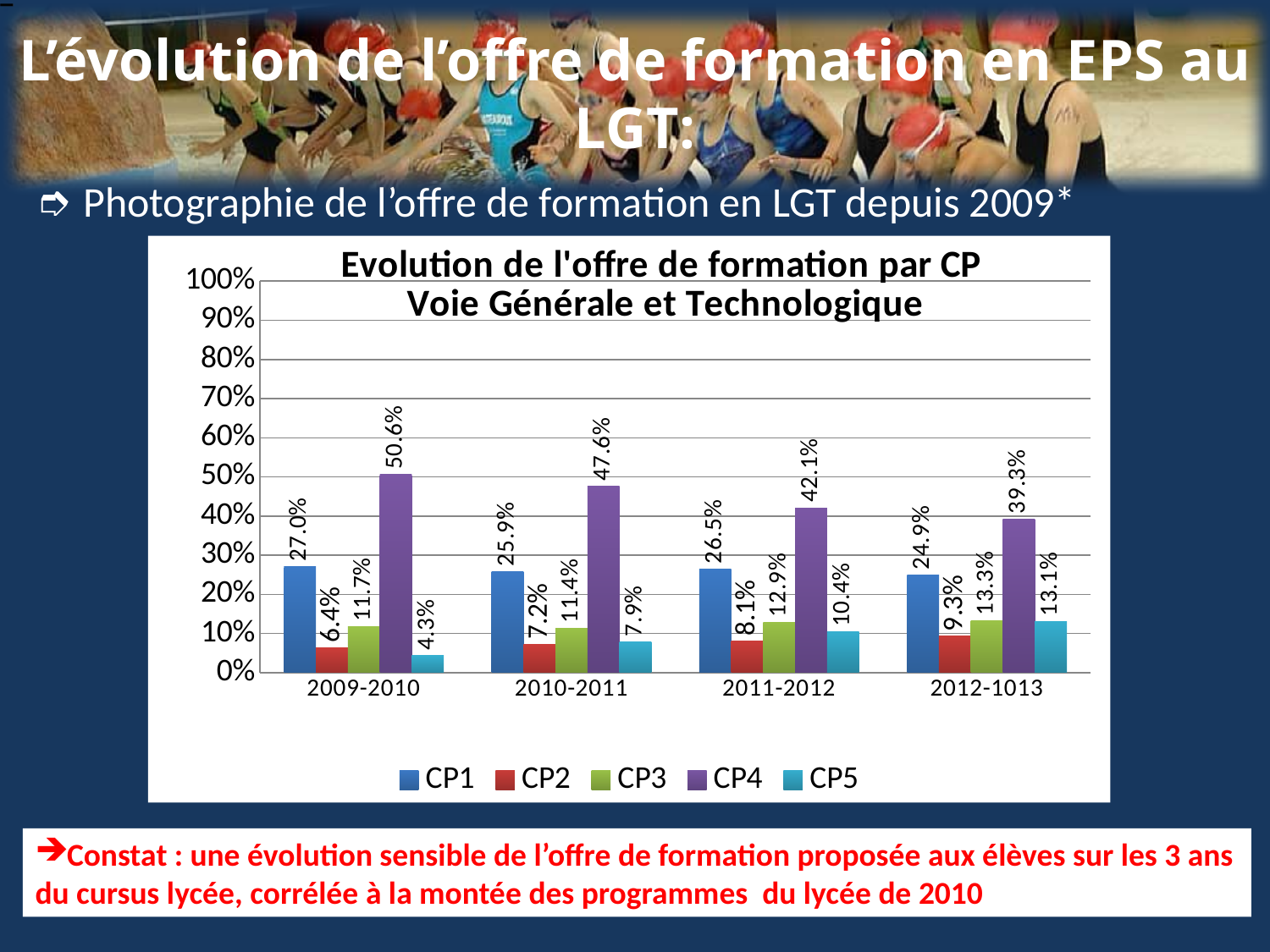
Does the value for CP4 rise or fall from 2009-2010 to 2012-1013? Fall What is the difference between CP4 in 2009-2010 and CP4 in 2012-1013? 11.3% What kind of chart is shown? Bar chart How many series does the legend list? 5 Which is larger in 2012-1013: CP3 or CP5? CP3 What is the title of the chart? Evolution de l'offre de formation par CP Voie Générale et Technologique How many school-year categories are shown on the x axis? 4 Which series has the highest value in 2010-2011? CP4 What is the value for CP4 in 2009-2010? 50.6% What is the value for CP5 in 2012-1013? 13.1% What is the value for CP2 in 2011-2012? 8.1% Which series has the lowest value in 2009-2010? CP5